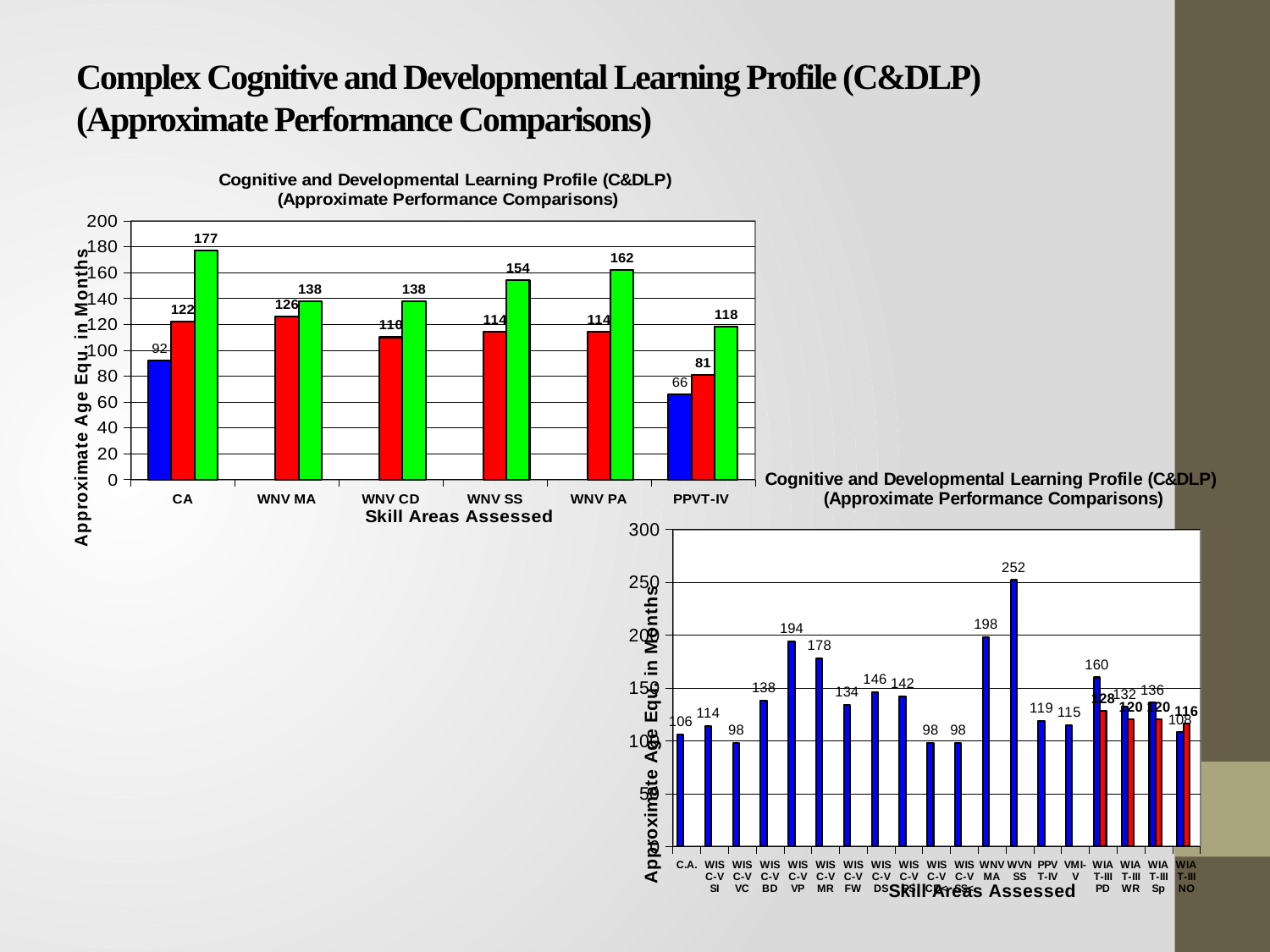
In the top-left chart, what is the value of the blue bar for PPVT-IV? 66 In the top-left chart, which category has the lowest green bar? PPVT-IV In the bottom-right chart, what is the value for WIS C-V VP? 194 What is the x-axis title of the bottom-right chart? Skill Areas Assessed In the top-left chart, what is the difference between the green and red bars for WNV PA? 48 In the top-left chart, how many categories are shown on the x axis? 6 In the bottom-right chart, what is the value for WVN SS? 252 In the bottom-right chart, which is larger, the value for WNV MA or the value for WIS C-V MR? WNV MA In the bottom-right chart, which category has the highest value? WVN SS In the top-left chart, what is the value of the green bar for CA? 177 What type of chart is the top-left chart? Bar chart In the top-left chart, what is the value of the red bar for WNV MA? 126